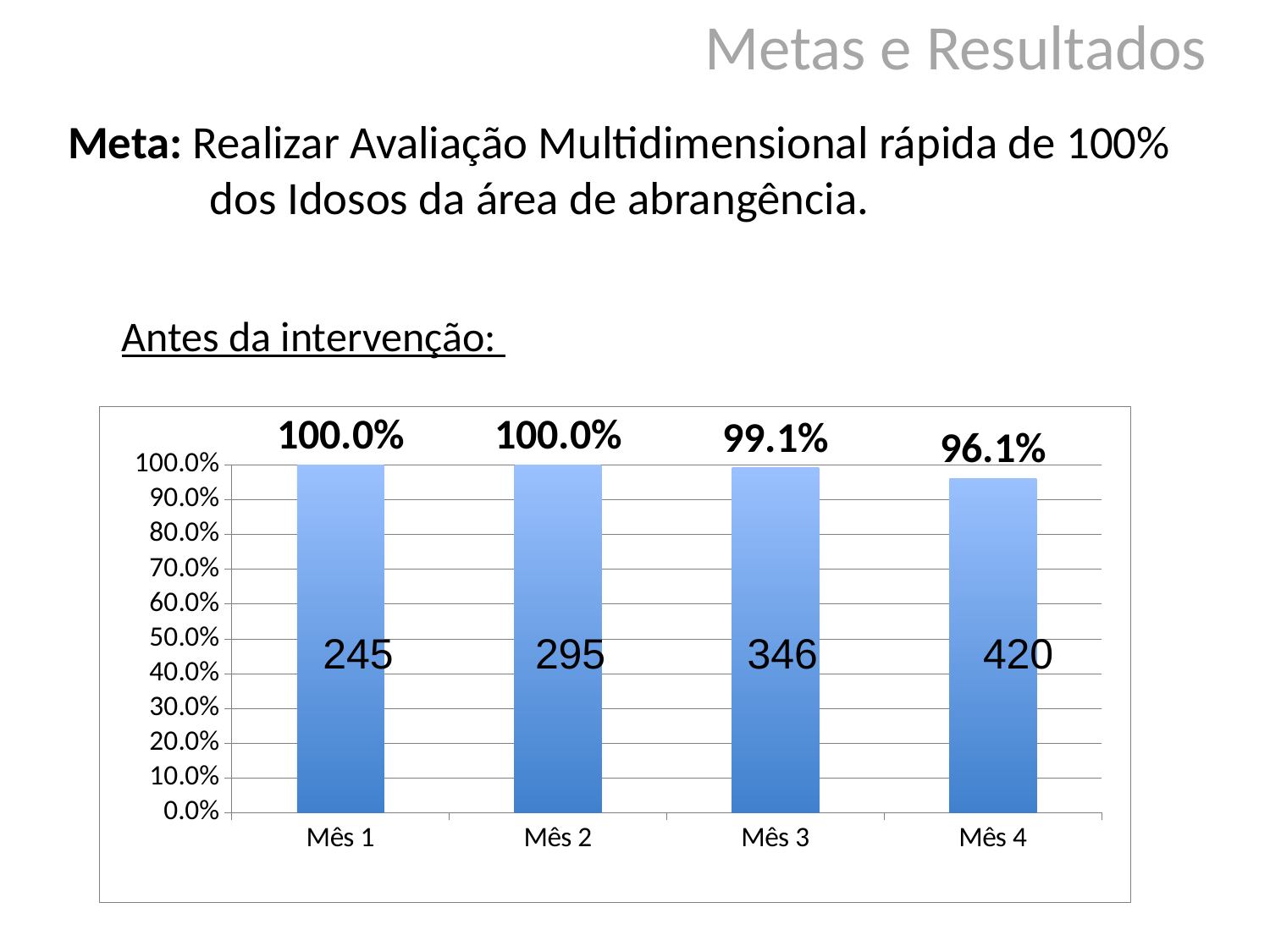
Which month has the lowest percentage? Mês 4 What number is printed inside the bar for Mês 1? 245 Which is larger, the percentage for Mês 3 or for Mês 4? Mês 3 What percentage is shown for Mês 3? 99.1% What kind of chart is shown on the slide? Bar chart Do the percentages rise or fall from Mês 2 to Mês 4? Fall What is the difference between the numbers printed inside the bars for Mês 4 and Mês 3? 74 What percentage is shown for Mês 4? 96.1% How many months (categories) are shown on the x axis? 4 What number is printed inside the bar for Mês 4? 420 What is the difference between the percentages for Mês 1 and Mês 4? 3.9% What is the underlined heading above the chart? Antes da intervenção: